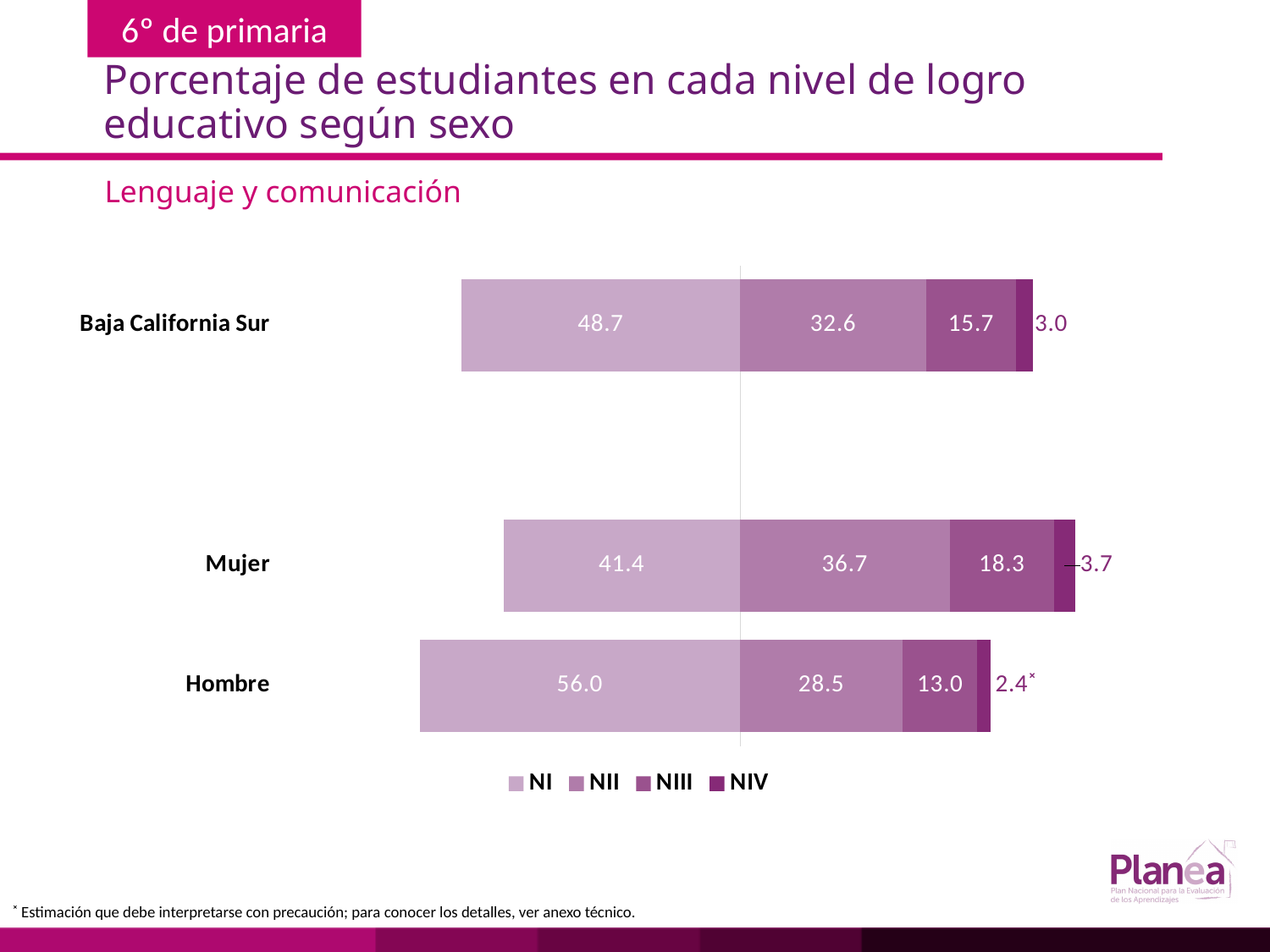
What is the NII value for Mujer? 36.7 What is the difference between the NI values for Hombre and Mujer? 14.6 What is the total of the stacked bar for Baja California Sur? 100.0 Which category has the highest NI value? Hombre How many categories are shown on the chart? 3 Which category has the lowest NIII value? Hombre What percentage of Hombre students are at level NI? 56.0 What is the NIII value for Baja California Sur? 15.7 Which is larger, the NIV value for Mujer or for Baja California Sur? Mujer What is the NIV value for Hombre? 2.4 What kind of chart is shown on the slide? Stacked bar chart How many series does the legend list? 4